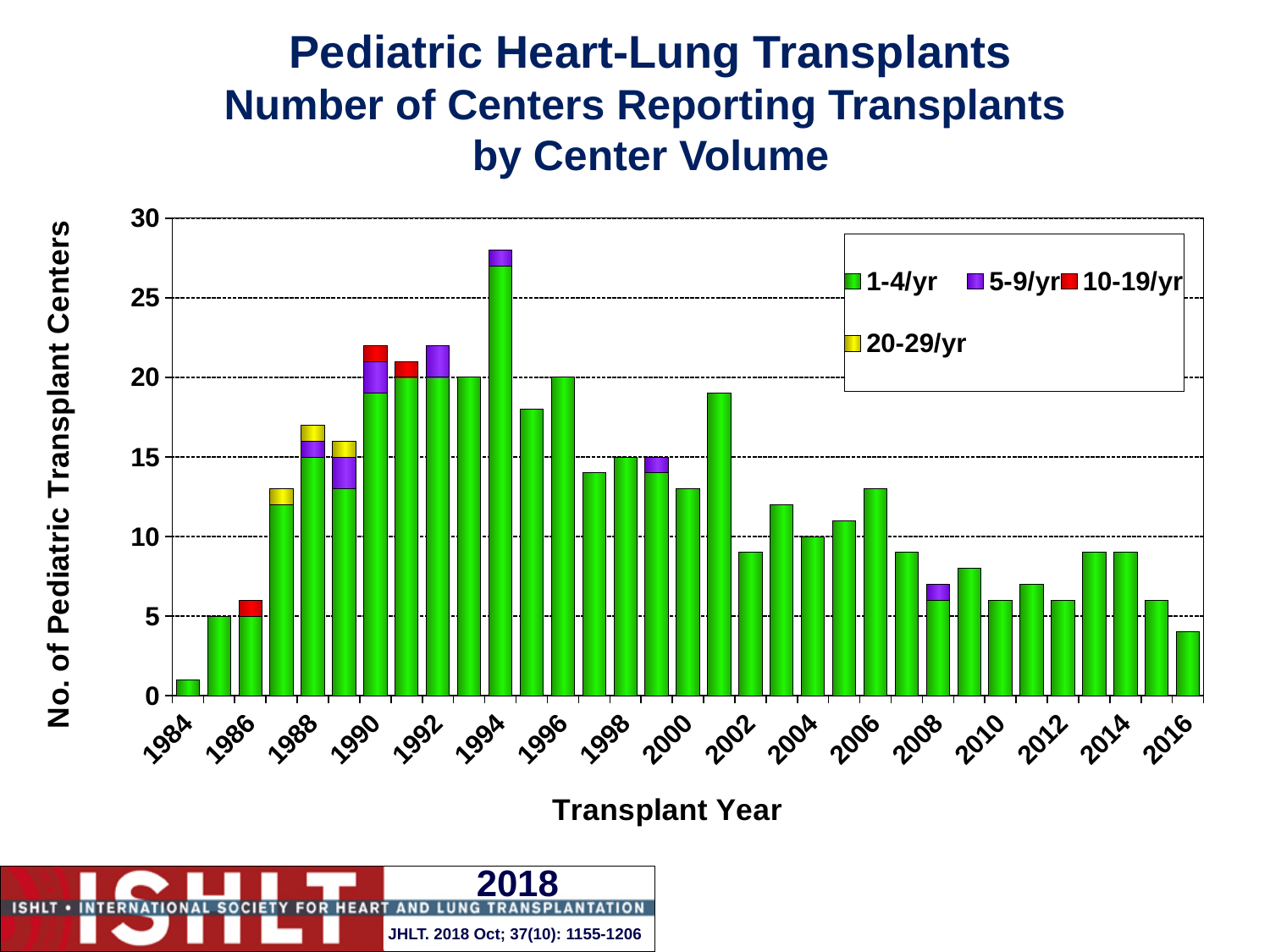
Is the total number of centers for 1994 greater or less than 25? greater Which transplant year has the highest total number of reporting centers? 1994 How many transplant years are plotted along the x axis? 33 Which year has more reporting centers in total, 2006 or 2012? 2006 Which colour represents the 10-19/yr series in the legend? Red Which transplant year has the lowest total number of reporting centers? 1984 What kind of chart is shown on the slide? Stacked bar chart Is the total number of centers for 2001 greater or less than 15? greater How many series does the legend list? 4 Do the total numbers of reporting centers generally rise or fall from 2001 to 2016? fall Is the total number of centers for 2016 greater or less than 5? less